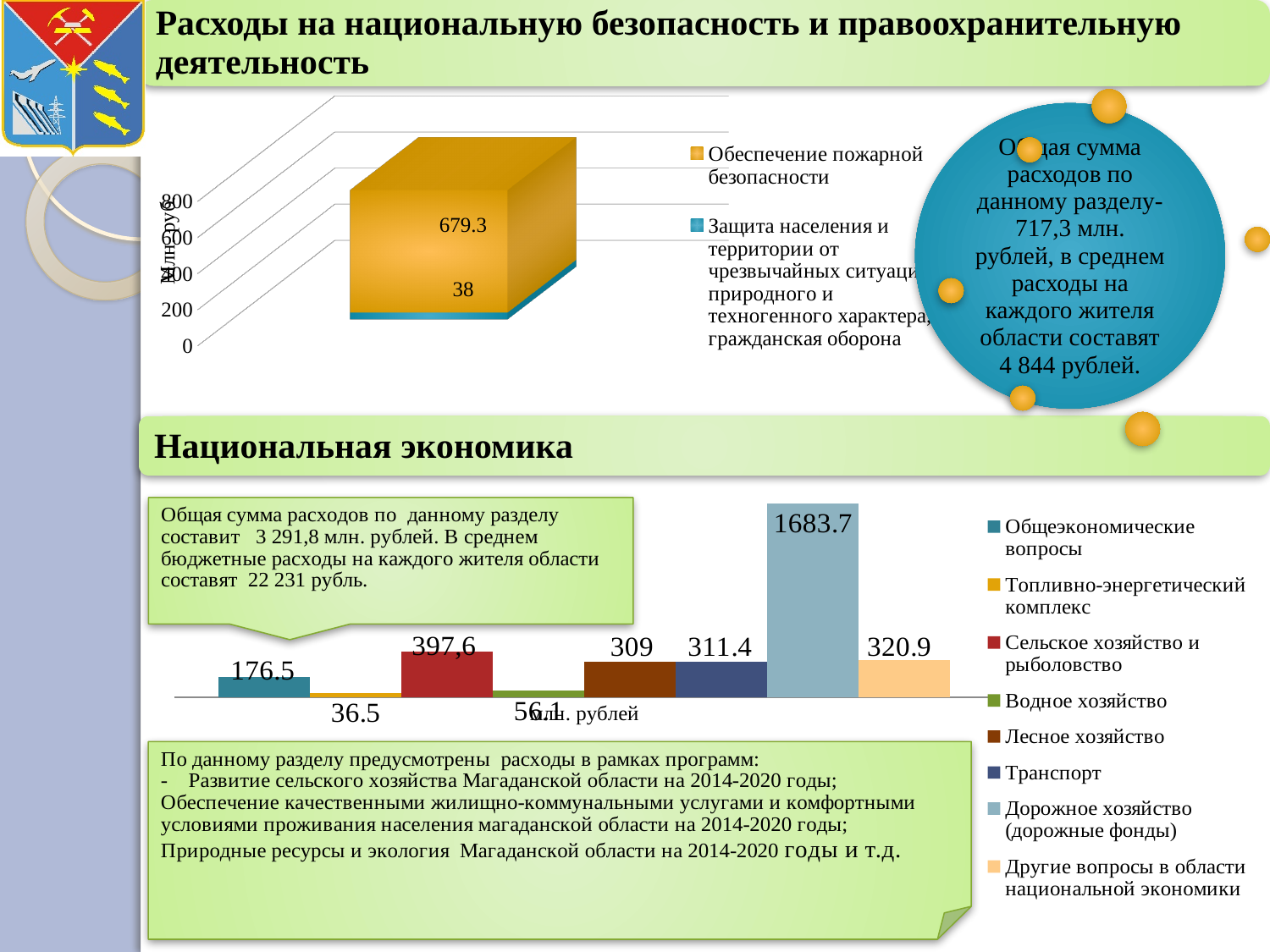
In the top chart, what is the value for Обеспечение пожарной безопасности? 679.3 In the bottom chart (Национальная экономика), which is larger: Сельское хозяйство и рыболовство or Транспорт? Сельское хозяйство и рыболовство In the top chart, what is the value for Защита населения и территории от чрезвычайных ситуаций? 38 In the bottom chart (Национальная экономика), what is the difference between Другие вопросы в области национальной экономики and Лесное хозяйство? 11.9 In the bottom chart (Национальная экономика), what is the value for Транспорт? 311.4 In the bottom chart (Национальная экономика), what is the value for Общеэкономические вопросы? 176.5 In the bottom chart (Национальная экономика), which category has the lowest value? Топливно-энергетический комплекс How many series does the legend of the top chart list? 2 In the bottom chart (Национальная экономика), which category has the highest value? Дорожное хозяйство (дорожные фонды) In the bottom chart (Национальная экономика), what is the value for Дорожное хозяйство (дорожные фонды)? 1683.7 In the top chart, what is the total of the stacked bar? 717.3 How many series does the legend of the bottom chart (Национальная экономика) list? 8